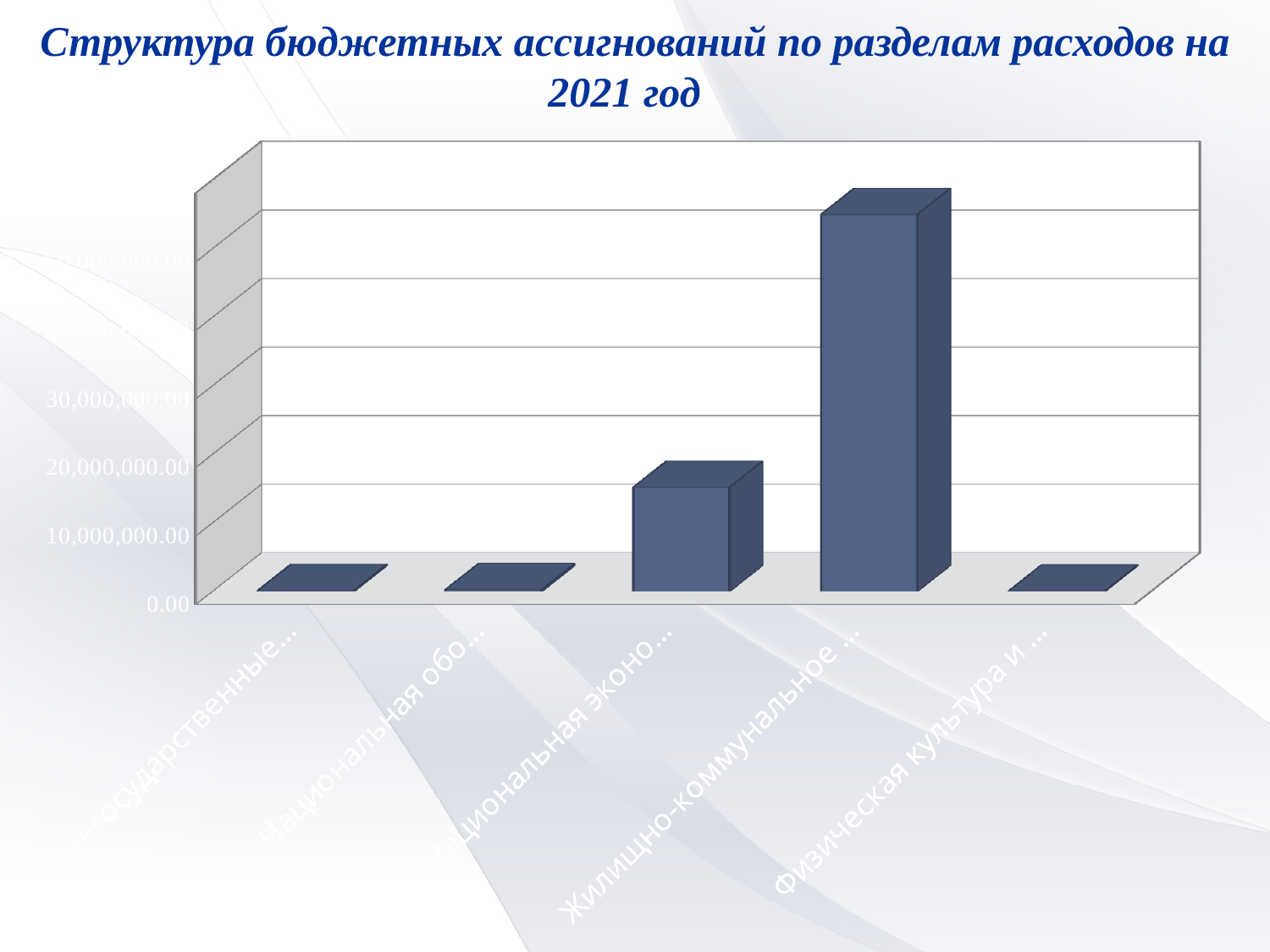
How many bars (categories) does the chart show? 5 Is the value for "Физическая культура и ..." greater or less than 10,000,000.00? less Is the value for "Национальная эконо..." greater or less than 20,000,000.00? less Which category has the highest bar in the chart? Жилищно-коммунальное ... What is the lowest value label shown on the vertical axis? 0.00 What is the title of the chart on the slide? Структура бюджетных ассигнований по разделам расходов на 2021 год Is the value for "Национальная эконо..." greater or less than 10,000,000.00? greater Which bar is larger: "Национальная эконо..." or "Жилищно-коммунальное ..."? Жилищно-коммунальное ... Which bar is larger: "Национальная обо..." or "Национальная эконо..."? Национальная эконо... What kind of chart is shown on the slide? Bar chart